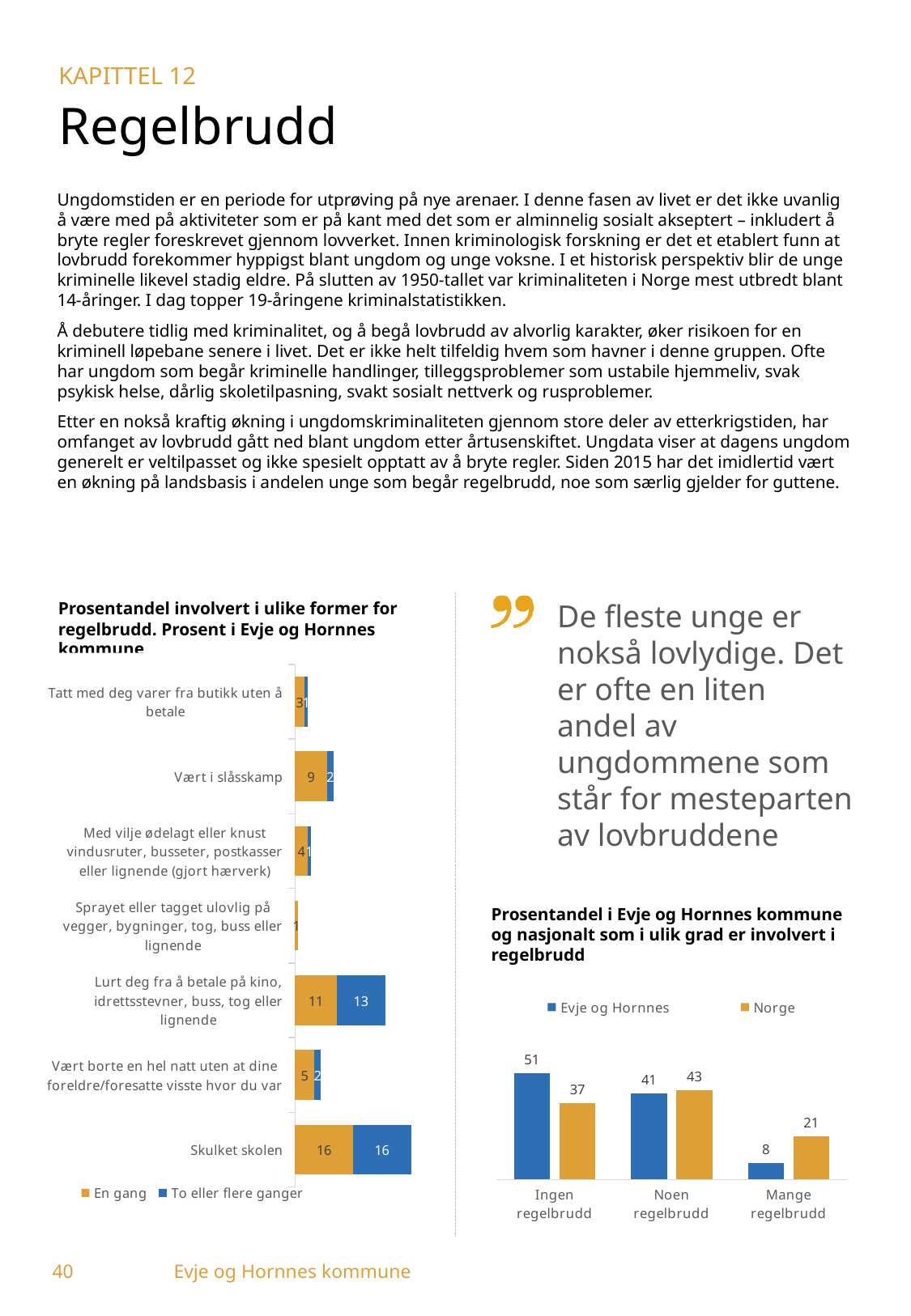
What kind of chart is the left chart (Prosentandel involvert i ulike former for regelbrudd)? Stacked bar chart In the left chart (Prosentandel involvert i ulike former for regelbrudd), what is the total of the stacked bar for 'Lurt deg fra å betale på kino, idrettsstevner, buss, tog eller lignende'? 24 In the left chart (Prosentandel involvert i ulike former for regelbrudd), what is the value of 'En gang' for Vært i slåsskamp? 9 In the right chart (Prosentandel i Evje og Hornnes kommune og nasjonalt), what is the value for Norge for Mange regelbrudd? 21 In the right chart (Prosentandel i Evje og Hornnes kommune og nasjonalt), what is the difference between Norge and Evje og Hornnes for Mange regelbrudd? 13 In the right chart (Prosentandel i Evje og Hornnes kommune og nasjonalt), which is larger for Noen regelbrudd: Evje og Hornnes or Norge? Norge In the right chart (Prosentandel i Evje og Hornnes kommune og nasjonalt), which category has the lowest value for Evje og Hornnes? Mange regelbrudd In the left chart (Prosentandel involvert i ulike former for regelbrudd), what is the value of 'To eller flere ganger' for Skulket skolen? 16 In the right chart (Prosentandel i Evje og Hornnes kommune og nasjonalt), what is the value for Evje og Hornnes for Ingen regelbrudd? 51 In the left chart (Prosentandel involvert i ulike former for regelbrudd), how many categories are shown? 7 In the left chart (Prosentandel involvert i ulike former for regelbrudd), which category has the highest total? Skulket skolen In the right chart (Prosentandel i Evje og Hornnes kommune og nasjonalt), how many series does the legend list? 2